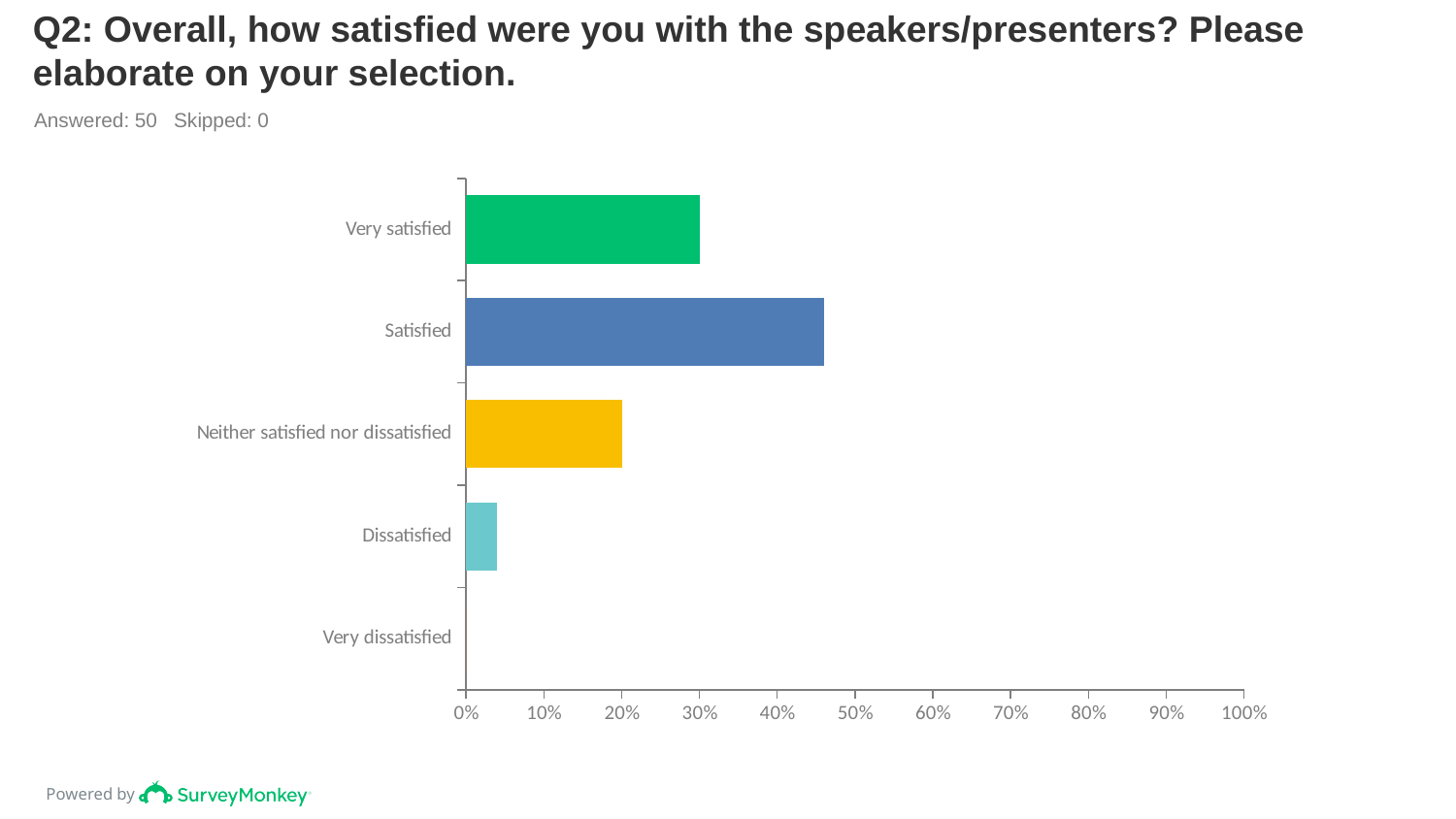
What type of chart is shown on the slide? bar chart What percentage of respondents selected 'Very dissatisfied'? 0% What percentage of respondents selected 'Very satisfied'? 30% What is the difference between the 'Very satisfied' and 'Neither satisfied nor dissatisfied' percentages? 10% How many people answered this question according to the slide? 50 Is the value for 'Dissatisfied' greater or less than 10%? less Which response category has the lowest percentage? Very dissatisfied How many response categories are shown on the chart? 5 What percentage of respondents selected 'Neither satisfied nor dissatisfied'? 20% Is the value for 'Satisfied' greater or less than 40%? greater Which is larger, the value for 'Very satisfied' or the value for 'Neither satisfied nor dissatisfied'? Very satisfied Which response category has the highest percentage? Satisfied